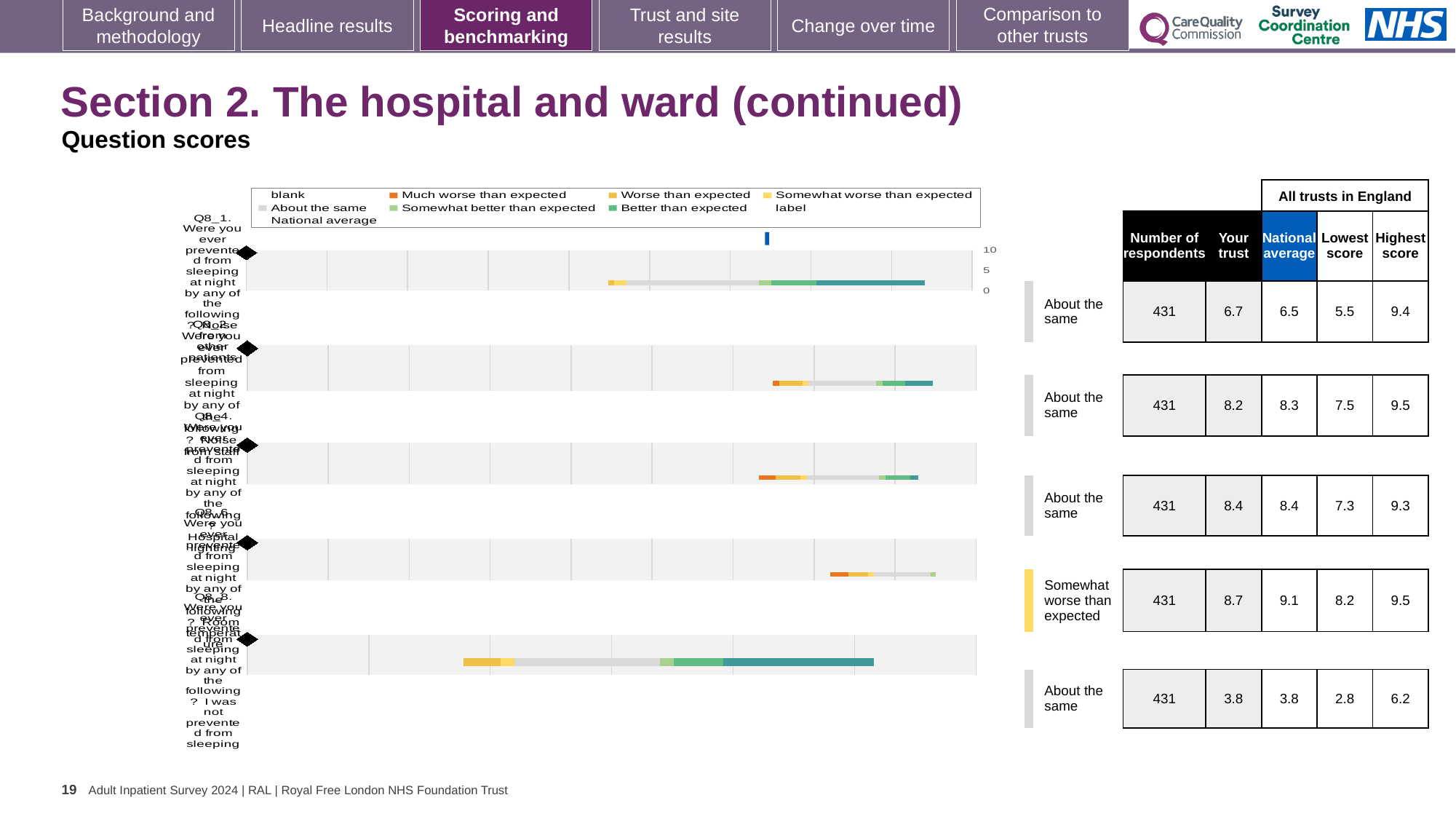
What is the difference between the national average and the 'Your trust' score for the fourth row from the top? 0.4 How many question rows (bars) are plotted in the chart? 5 For the fourth row from the top, which is larger: the 'Your trust' score or the national average? National average Which row has the lowest 'Your trust' score? the bottom row (3.8) What is the number of respondents for the bottom row? 431 Which legend entry is shown in grey? About the same What is the 'Your trust' score for the fourth row from the top? 8.7 What kind of chart is shown on the slide? bar chart What is the national average for the top row? 6.5 Which row has the highest 'Your trust' score? the fourth row from the top (8.7) Which legend entry is shown in dark orange? Much worse than expected What is the highest score among all trusts in England for the bottom row? 6.2